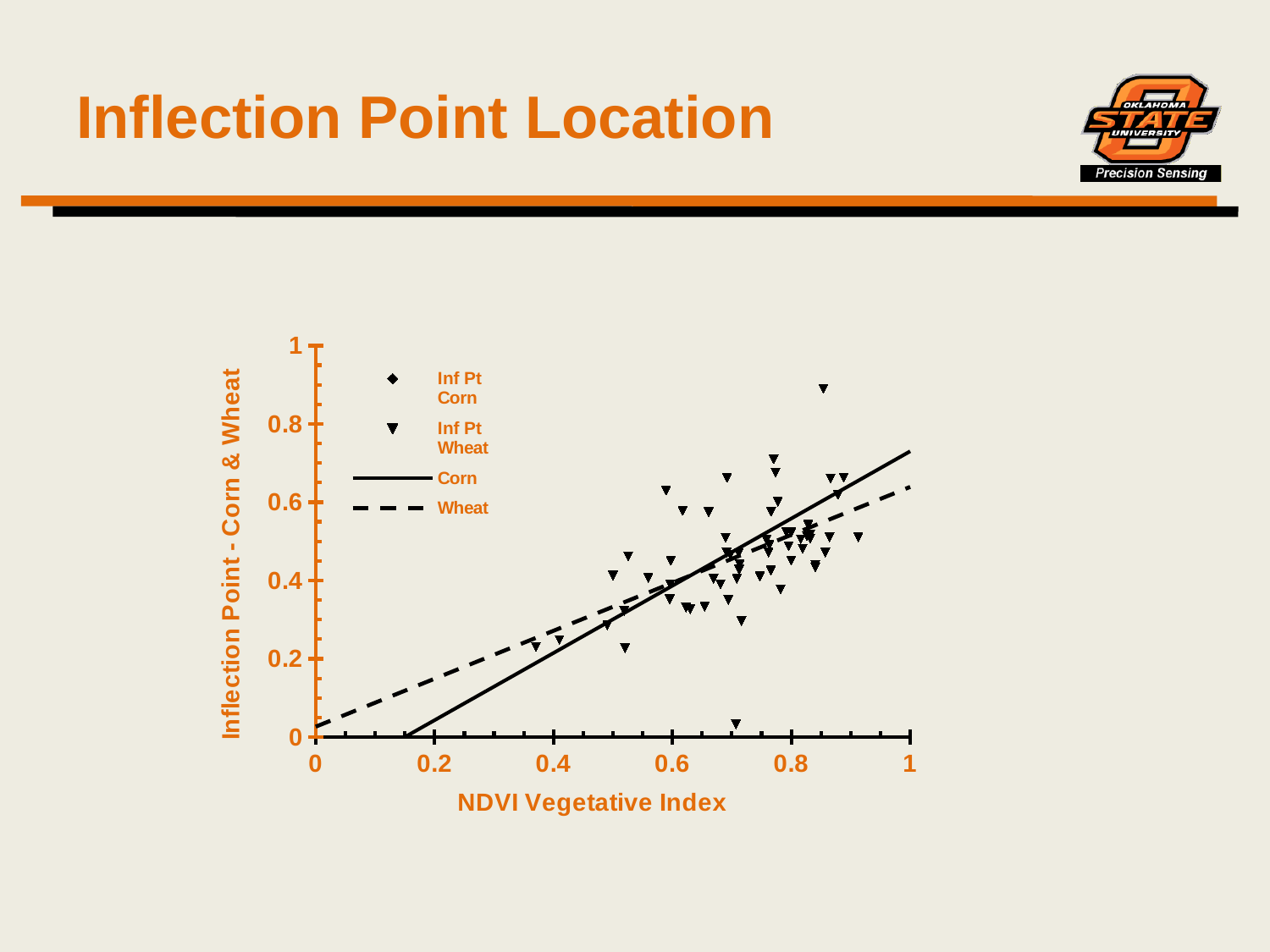
What is the title of the x axis? NDVI Vegetative Index At an NDVI of 0.2, is the value of the solid Corn line greater or less than 0.2? less At an NDVI of 0.2, which line is higher, the solid Corn line or the dashed Wheat line? Wheat Is the lowest Inf Pt Wheat data point greater or less than 0.2 on the y axis? less Is the highest Inf Pt Wheat data point greater or less than 0.8 on the y axis? greater Do the Corn and Wheat trend lines rise or fall as NDVI increases along the x axis? rise What kind of chart is shown on the slide? scatter chart What is the title of the y axis? Inflection Point - Corn & Wheat At an NDVI of 1, which line is higher, the solid Corn line or the dashed Wheat line? Corn How many entries does the chart legend list? 4